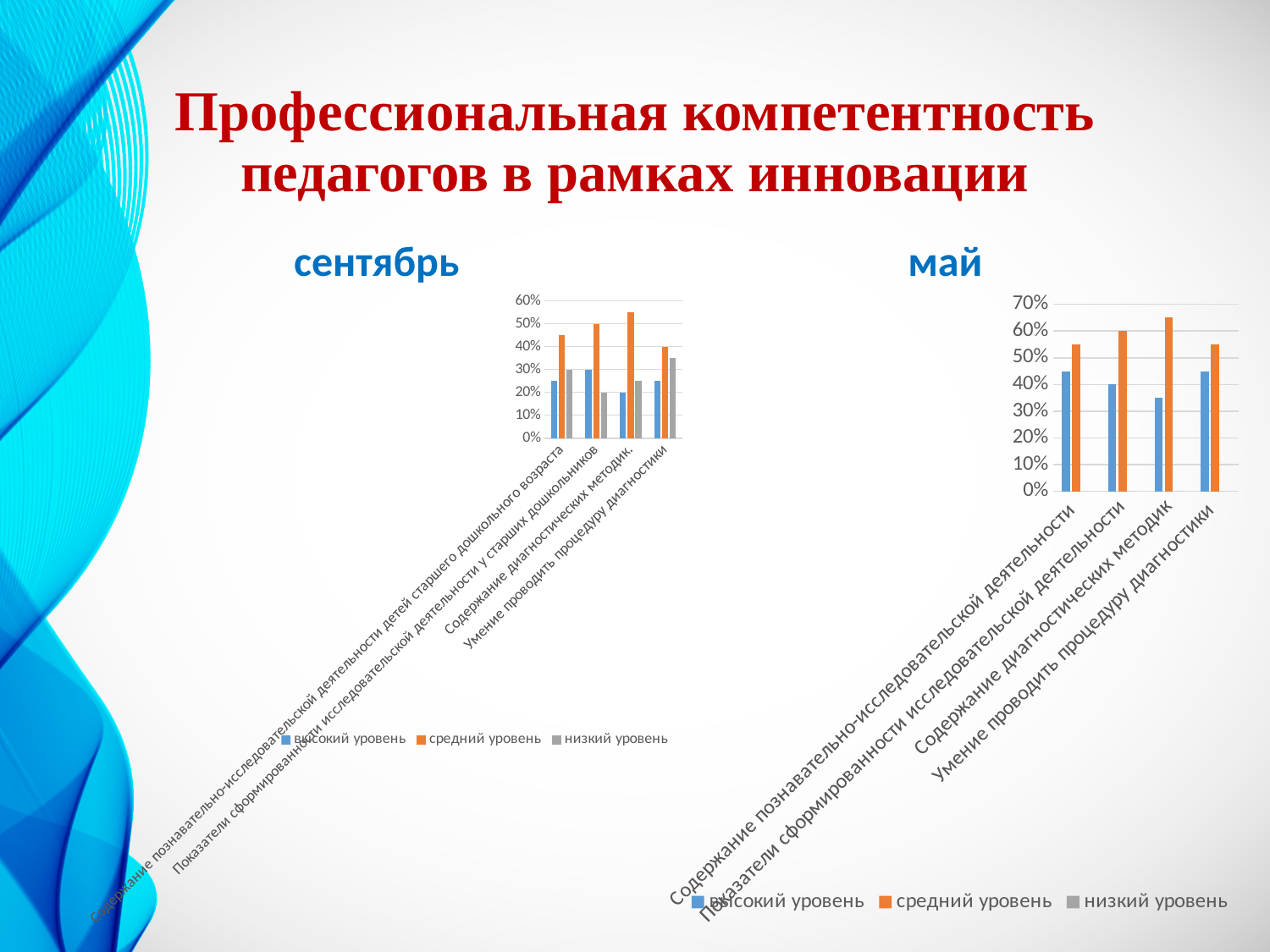
In the "сентябрь" chart, is the средний уровень value for Содержание диагностических методик greater or less than 50%? greater In the "сентябрь" chart, is the высокий уровень value for Умение проводить процедуру диагностики greater or less than 30%? less What is the highest value shown on the y axis of the "май" chart? 70% In the "май" chart, is the средний уровень value for Содержание диагностических методик greater or less than 60%? greater In the "май" chart, which category has the highest value for средний уровень? Содержание диагностических методик How many categories are shown on the x axis of the "май" chart? 4 In the "сентябрь" chart, which category has the highest value for средний уровень? Содержание диагностических методик. In the "май" chart, for Умение проводить процедуру диагностики, which is larger: высокий уровень or средний уровень? средний уровень In the "май" chart, which category has the lowest value for высокий уровень? Содержание диагностических методик How many series does the legend of the "сентябрь" chart list? 3 What kind of chart is the "сентябрь" chart? bar chart In the "май" chart, what colour represents средний уровень in the legend? orange